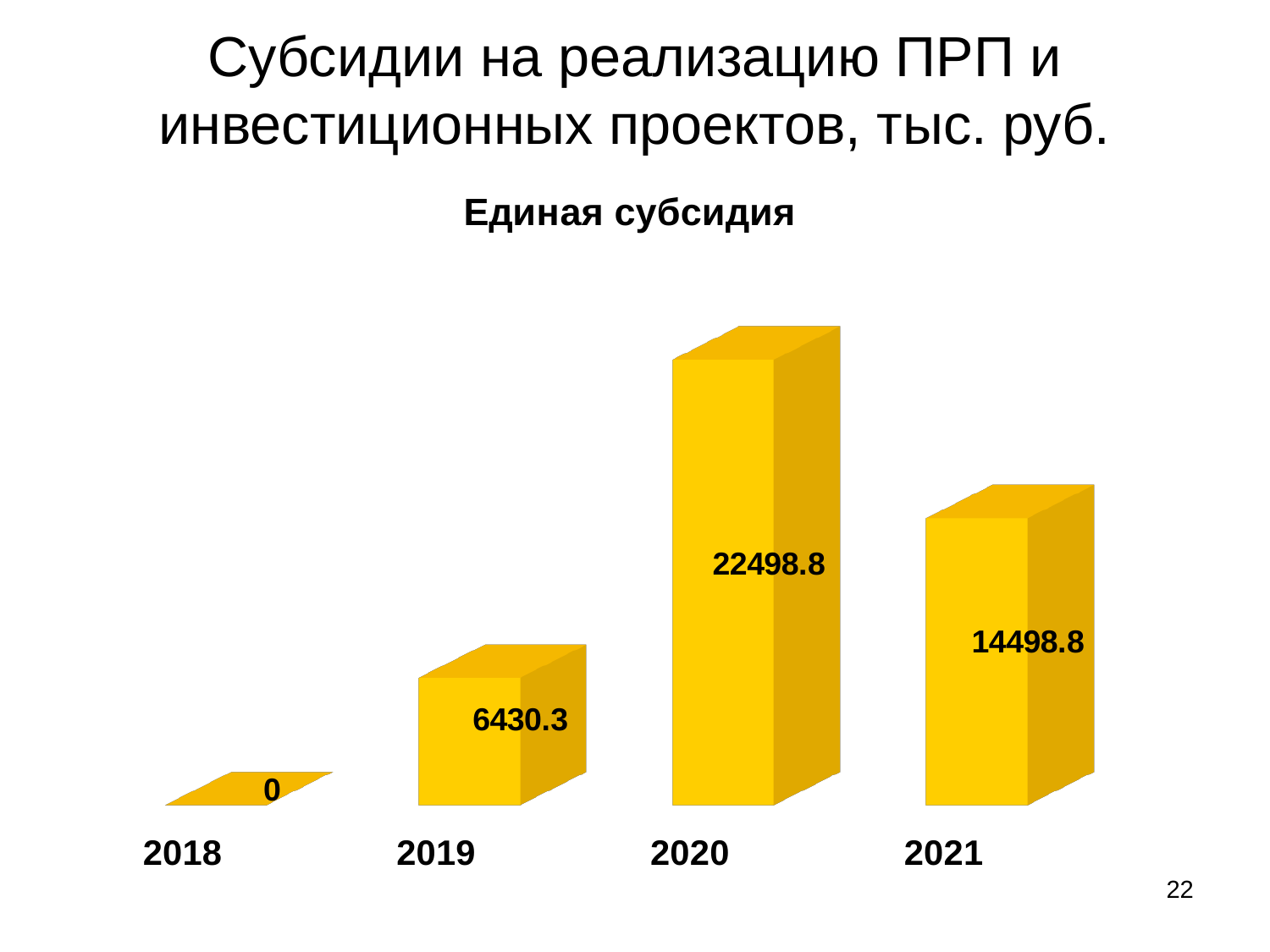
What is the difference between the values for 2021 and 2019? 8068.5 What kind of chart is shown on the slide? bar chart What is the value for 2018? 0 Which year has the highest value? 2020 How many years are shown on the x axis? 4 What is the title of the chart? Единая субсидия What is the value for 2019? 6430.3 Which is larger, the value for 2019 or the value for 2021? 2021 What is the difference between the values for 2020 and 2021? 8000 Which year has the lowest value? 2018 What is the value for 2021? 14498.8 What is the value for 2020? 22498.8